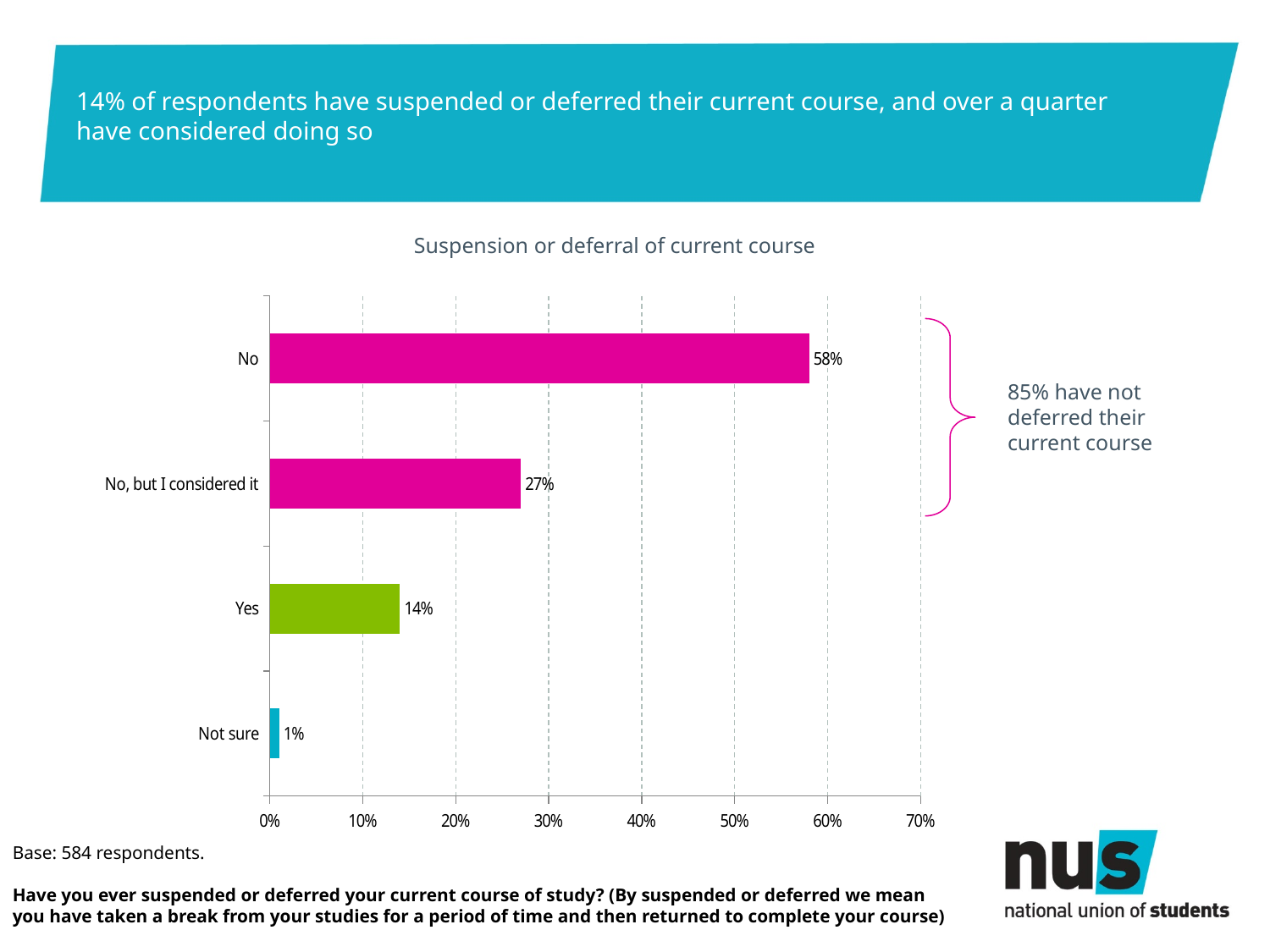
Which response category has the highest value? No What percentage of respondents answered "No, but I considered it"? 27% Which is larger, the value for "Yes" or the value for "No, but I considered it"? No, but I considered it What is the title of the chart? Suspension or deferral of current course Which response category has the lowest value? Not sure What type of chart is shown on the slide? Bar chart What is the difference between the "Yes" and "Not sure" values? 13% What is the difference between the "No" and "No, but I considered it" values? 31% What percentage of respondents answered "Yes"? 14% What percentage of respondents answered "Not sure"? 1% How many response categories are shown in the chart? 4 What percentage of respondents answered "No"? 58%